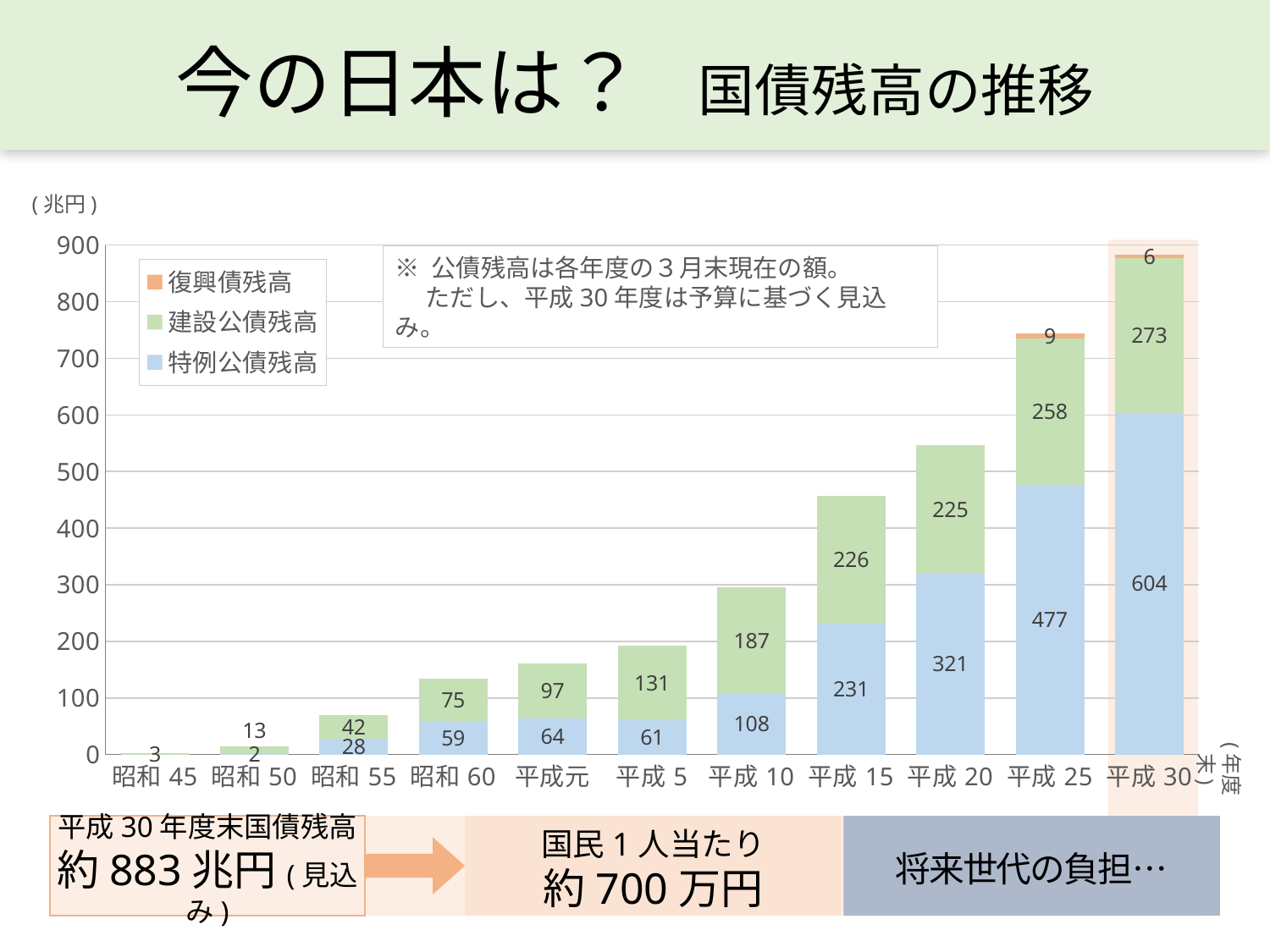
Which fiscal year has the highest total bond balance? 平成30 What is the value of 復興債残高 for 平成25? 9 How many fiscal years (categories) are shown on the x axis? 11 What type of chart is shown on the slide? stacked bar chart How many series does the legend list? 3 What is the difference between 特例公債残高 for 平成30 and 平成25? 127 What is the value of 建設公債残高 for 平成25? 258 What is the value of 特例公債残高 for 平成30? 604 Do the total bond balances rise or fall from 昭和45 to 平成30? rise Which is larger for 平成15: 特例公債残高 or 建設公債残高? 特例公債残高 What is the total stacked value for 平成20? 546 What is the total stacked value for 平成30? 883